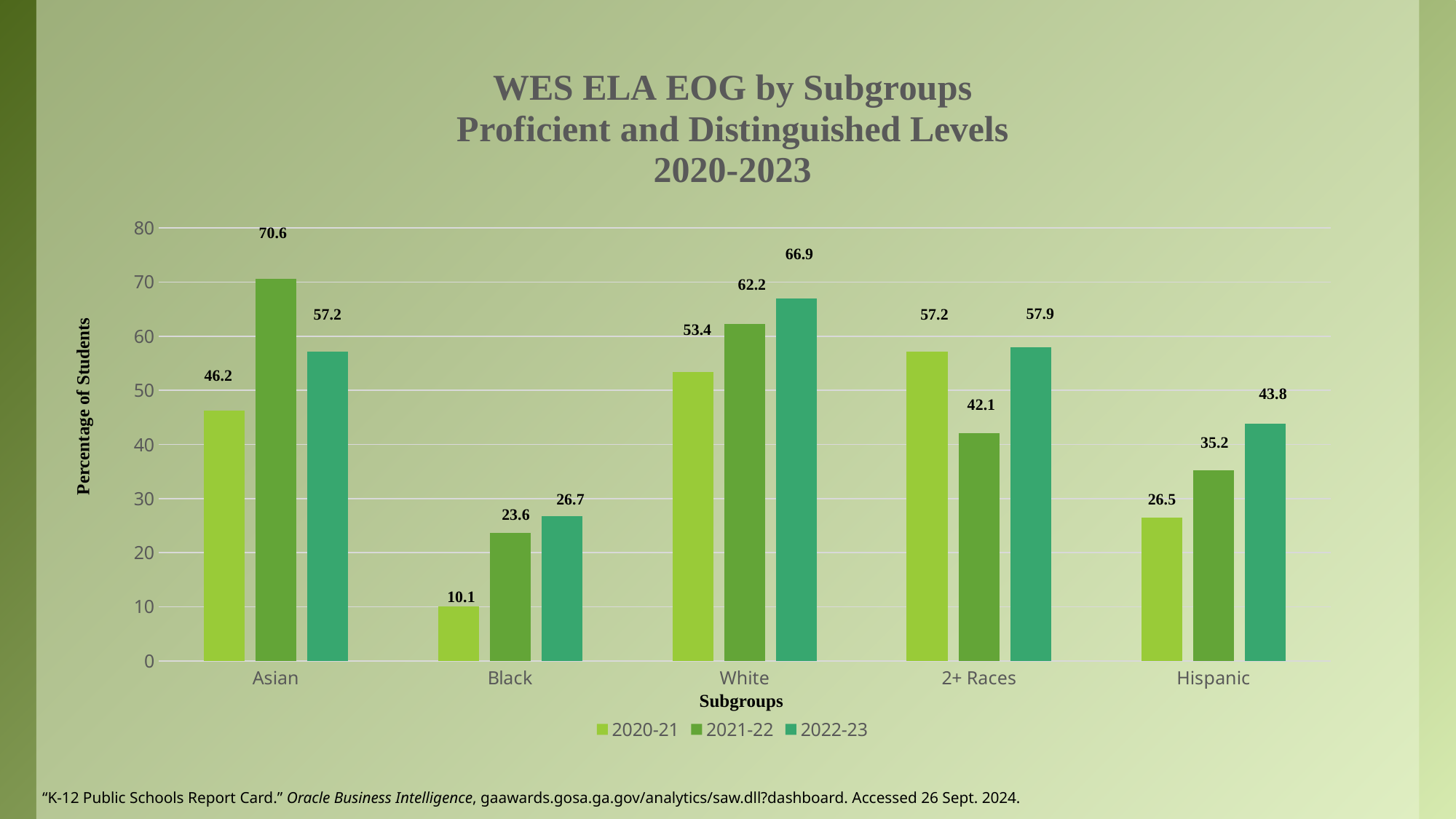
What is the value for Hispanic in the 2022-23 series? 43.8 Is the 2021-22 value for Hispanic greater or less than 30? greater What is the label of the y axis? Percentage of Students What is the value for Black in the 2020-21 series? 10.1 Which is larger for 2+ Races: the 2020-21 value or the 2021-22 value? 2020-21 How many subgroups are shown on the x axis? 5 What is the value for Asian in the 2021-22 series? 70.6 What kind of chart is shown on the slide? bar chart What is the difference between the 2021-22 and 2020-21 values for White? 8.8 Which subgroup has the lowest value in the 2020-21 series? Black Which subgroup has the highest value in the 2022-23 series? White How many series does the legend list? 3